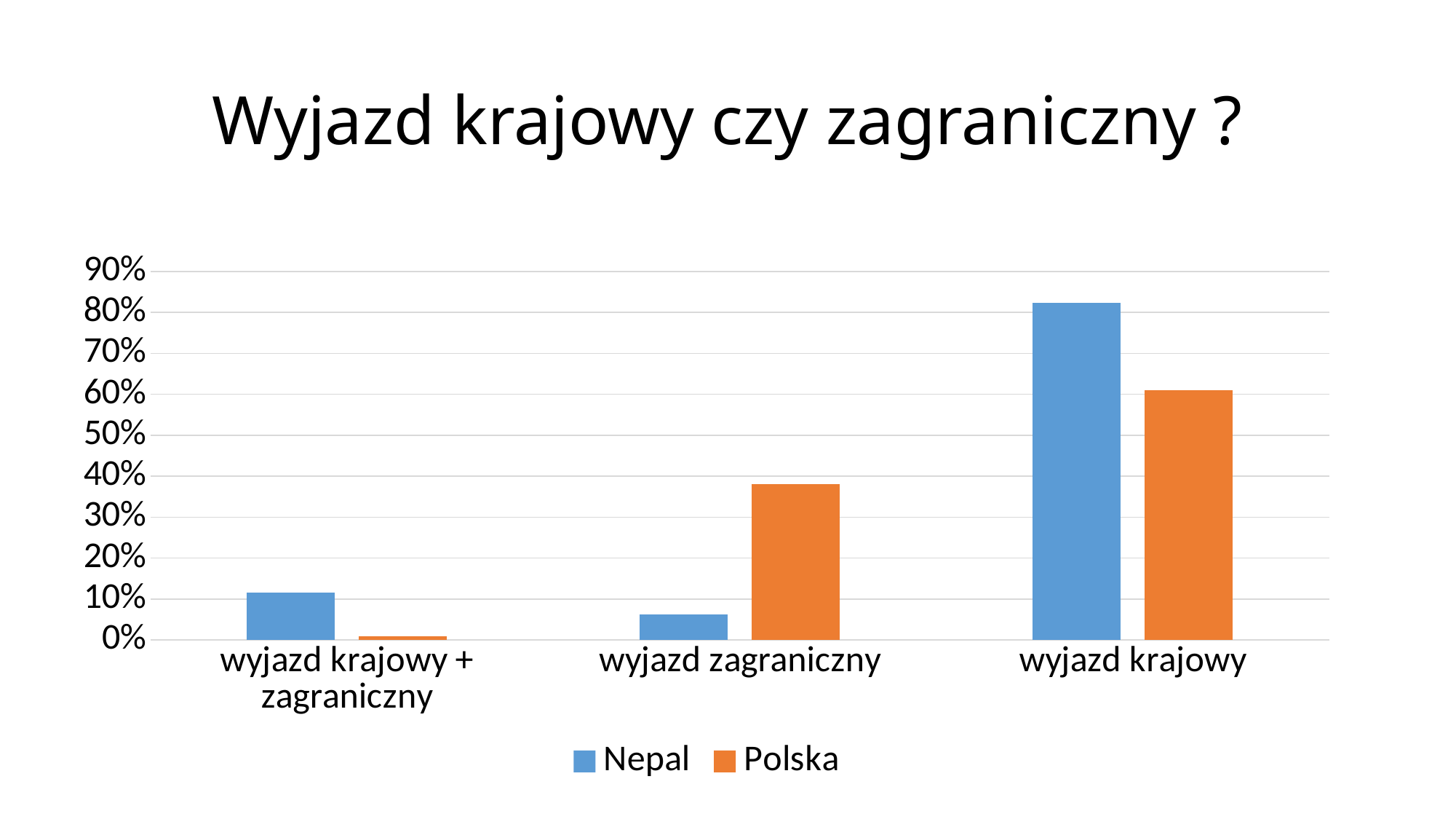
Which category has the highest value for Nepal? wyjazd krajowy How many series does the legend list? 2 Is the value for Nepal in wyjazd zagraniczny greater or less than 10%? less For wyjazd krajowy, which series has the larger value, Nepal or Polska? Nepal How many categories are shown on the x axis? 3 Which category has the lowest value for Nepal? wyjazd zagraniczny Is the value for Nepal in wyjazd krajowy greater or less than 70%? greater Is the value for Polska in wyjazd zagraniczny greater or less than 30%? greater What is the title of the slide? Wyjazd krajowy czy zagraniczny ? For wyjazd zagraniczny, which series has the larger value, Nepal or Polska? Polska What kind of chart is shown on the slide? bar chart Which category has the lowest value for Polska? wyjazd krajowy + zagraniczny